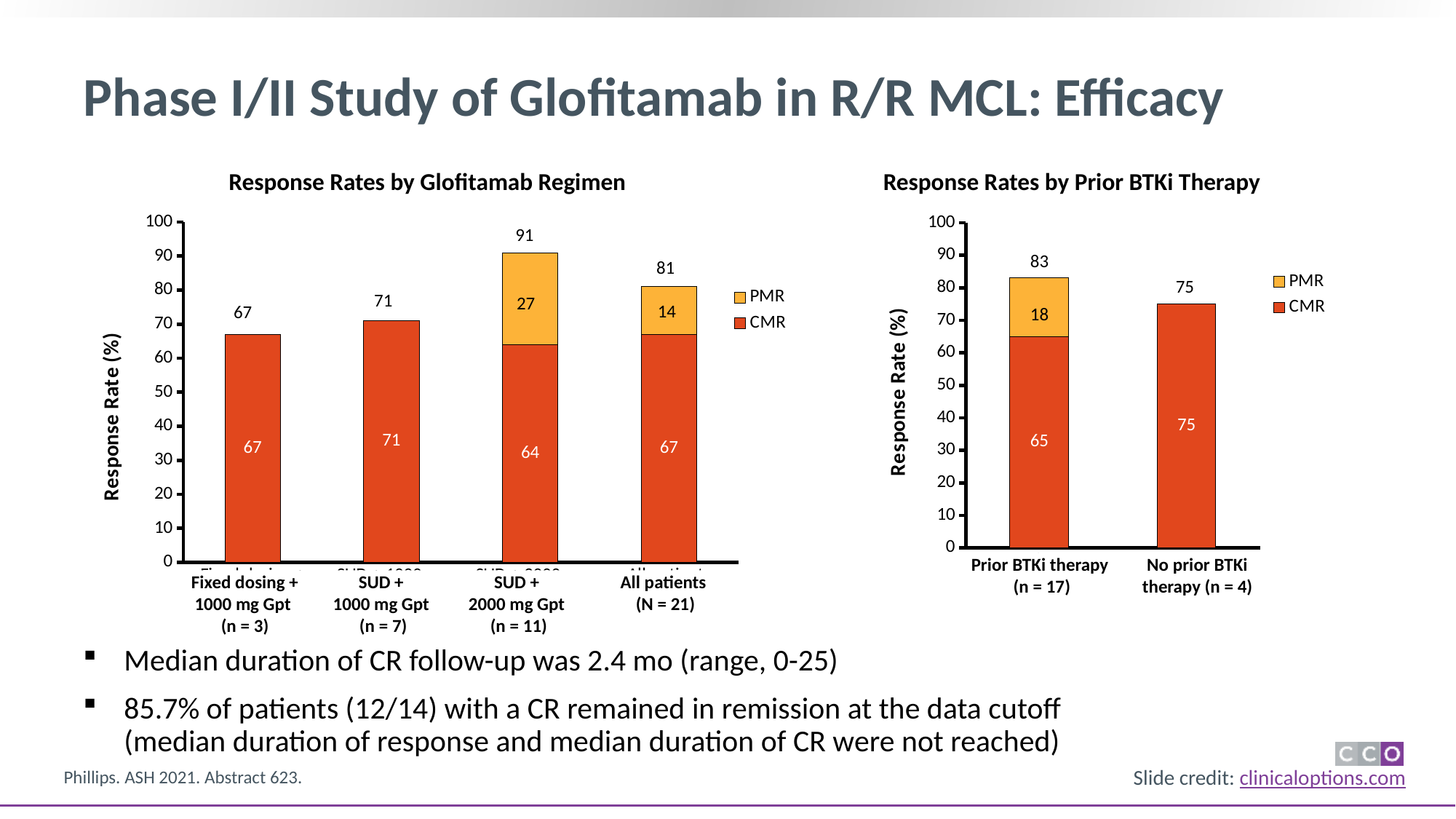
In the 'Response Rates by Prior BTKi Therapy' chart, which group has the larger CMR value, Prior BTKi therapy or No prior BTKi therapy? No prior BTKi therapy In the 'Response Rates by Glofitamab Regimen' chart, what is the CMR value for SUD + 2000 mg Gpt (n = 11)? 64 In the 'Response Rates by Prior BTKi Therapy' chart, what is the difference between the total response rates for Prior BTKi therapy and No prior BTKi therapy? 8 In the 'Response Rates by Glofitamab Regimen' chart, what is the difference between the PMR values for SUD + 2000 mg Gpt and All patients? 13 What type of chart is 'Response Rates by Glofitamab Regimen'? Stacked bar chart How many series does the legend of the 'Response Rates by Prior BTKi Therapy' chart list? 2 In the 'Response Rates by Prior BTKi Therapy' chart, what is the PMR value for Prior BTKi therapy (n = 17)? 18 In the 'Response Rates by Glofitamab Regimen' chart, which regimen has the lowest total response rate? Fixed dosing + 1000 mg Gpt (n = 3) In the 'Response Rates by Glofitamab Regimen' chart, what is the total response rate for All patients (N = 21)? 81 In the 'Response Rates by Glofitamab Regimen' chart, which regimen has the highest total response rate? SUD + 2000 mg Gpt (n = 11) In the 'Response Rates by Glofitamab Regimen' chart, how many regimen categories are shown on the x axis? 4 In the 'Response Rates by Prior BTKi Therapy' chart, what is the CMR value for No prior BTKi therapy (n = 4)? 75